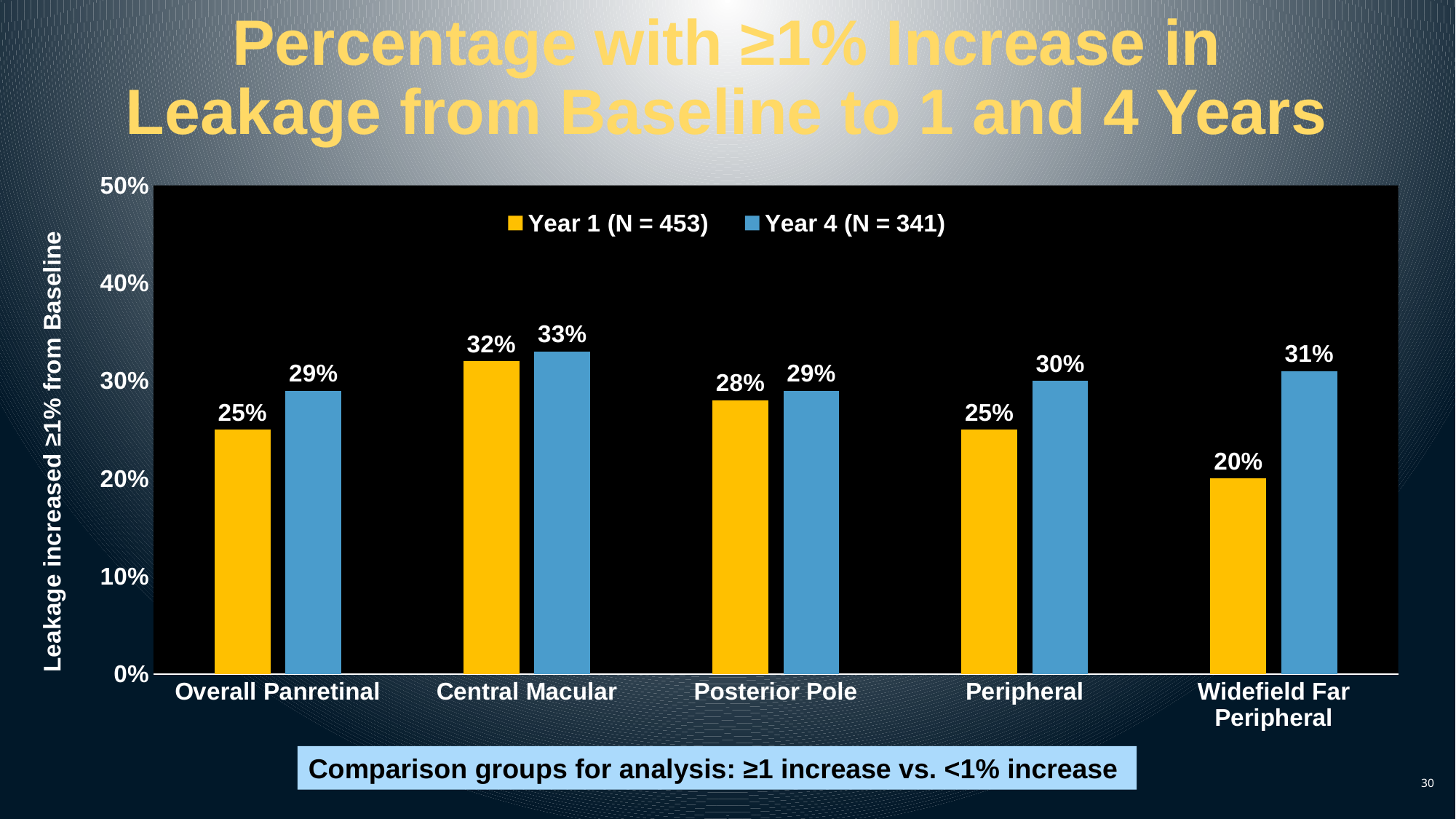
How many series does the legend list? 2 Is the Year 1 (N = 453) value for Central Macular greater or less than 30%? greater What is the Year 4 (N = 341) value for Widefield Far Peripheral? 31% Which category has the highest Year 4 (N = 341) value? Central Macular How many categories are shown on the x axis? 5 Which is larger for Posterior Pole: the Year 1 (N = 453) value or the Year 4 (N = 341) value? Year 4 (N = 341) What kind of chart is shown on the slide? Bar chart What is the difference between the Year 4 and Year 1 values for Peripheral? 5% What is the Year 4 (N = 341) value for Overall Panretinal? 29% What is the Year 1 (N = 453) value for Central Macular? 32% Which category has the lowest Year 1 (N = 453) value? Widefield Far Peripheral What is the difference between the Year 4 and Year 1 values for Widefield Far Peripheral? 11%